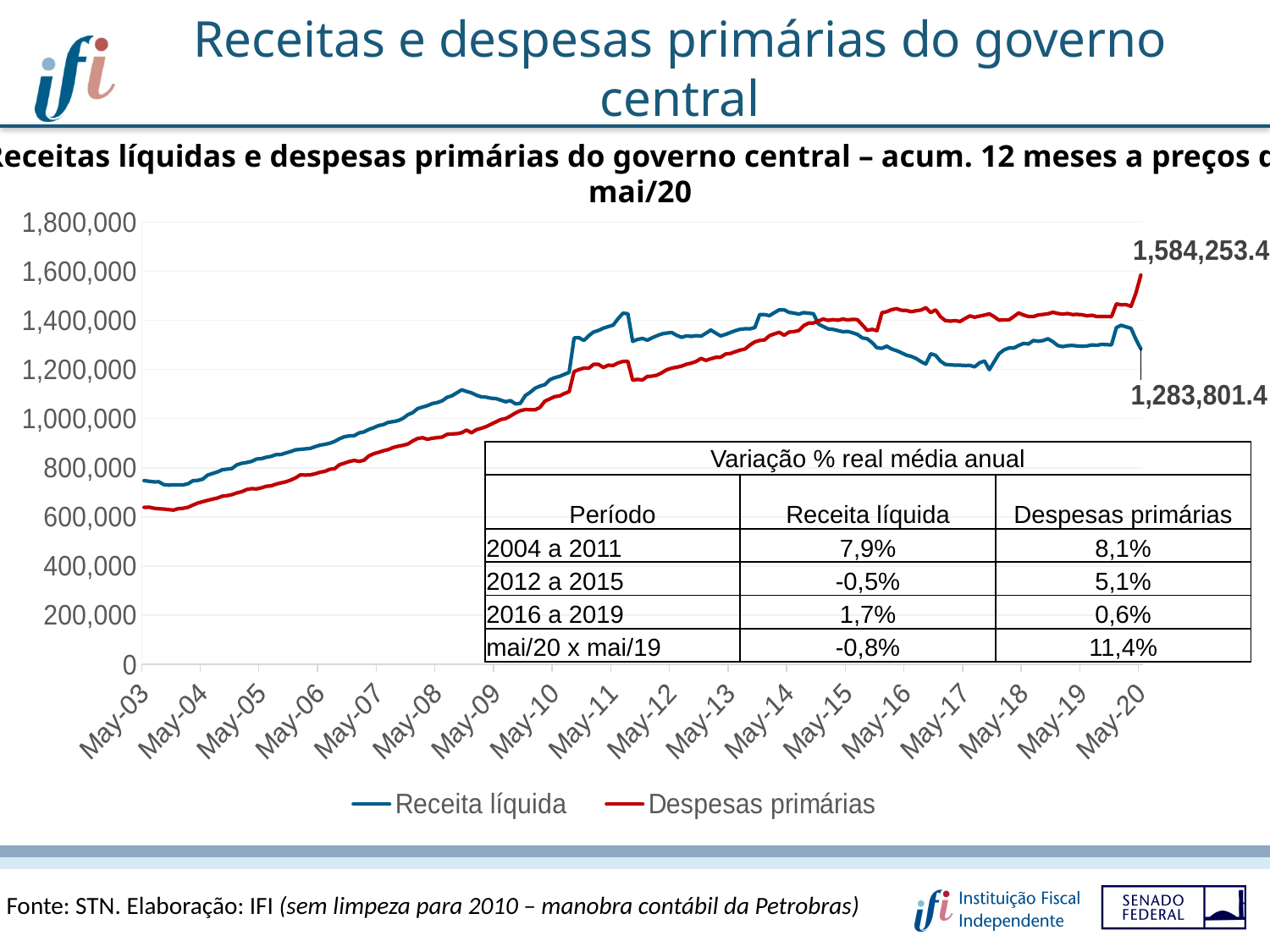
How many series does the chart legend list? 2 What kind of chart is shown on the slide? line chart What is the difference between the labelled May-20 values of Despesas primárias and Receita líquida? 300,452.0 What is the value labelled for Despesas primárias at the end of the series (May-20)? 1,584,253.4 What are the two series named in the chart legend? Receita líquida and Despesas primárias In the table 'Variação % real média anual', what is the Despesas primárias value for mai/20 x mai/19? 11,4% At May-20, which series is higher: Receita líquida or Despesas primárias? Despesas primárias Is the value for Despesas primárias at May-03 greater or less than 800,000? less What is the value labelled for Receita líquida at the end of the series (May-20)? 1,283,801.4 Is the value for Receita líquida at May-03 greater or less than 800,000? less At May-03, which series is higher: Receita líquida or Despesas primárias? Receita líquida Overall, do the Despesas primárias values rise or fall from May-03 to May-20? rise